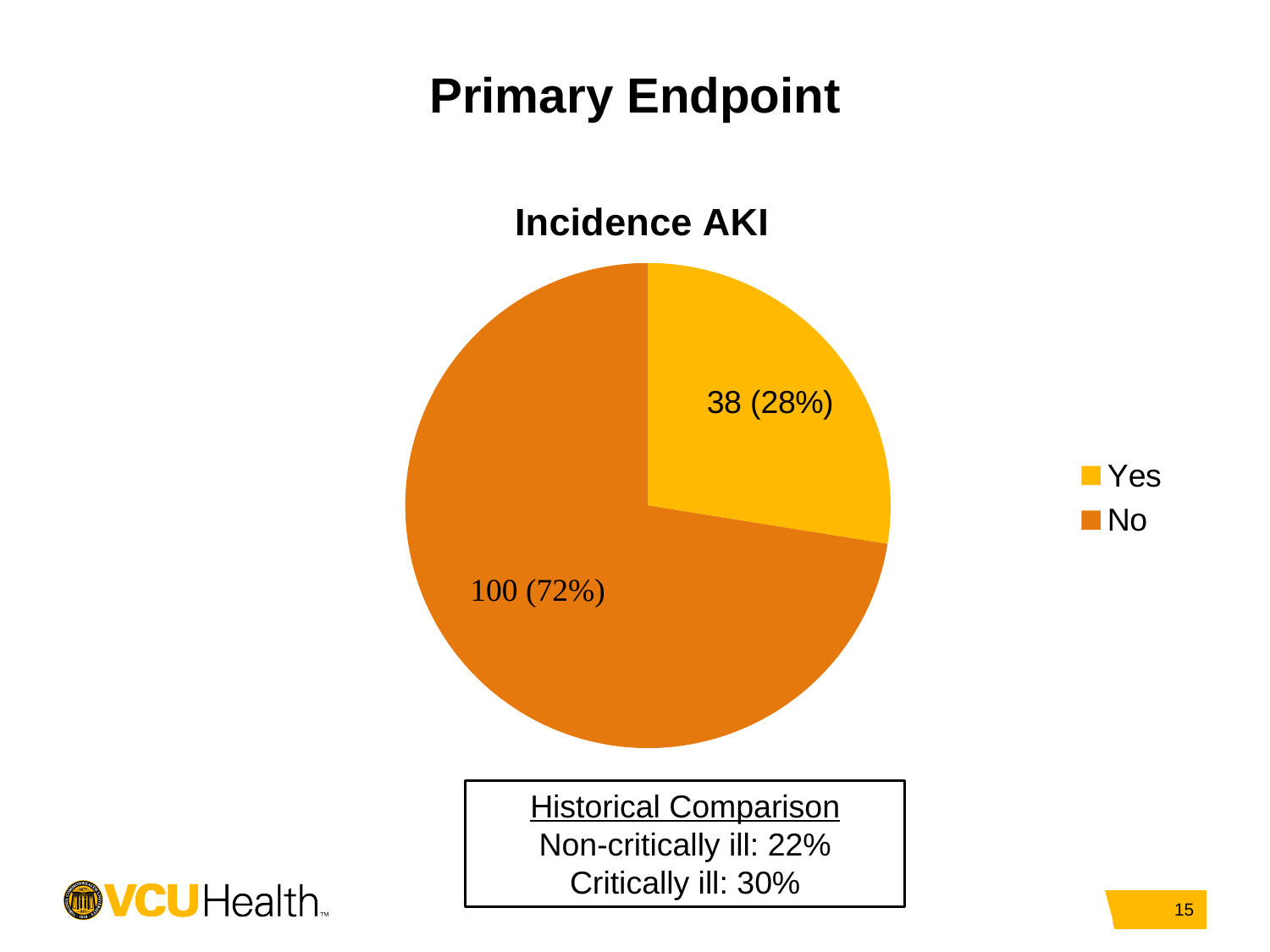
What is the title of the chart? Incidence AKI What type of chart is shown on the slide? pie chart Which slice is the largest? No What is the data label shown on the 'Yes' slice? 38 (28%) What is the data label shown on the 'No' slice? 100 (72%) Which slice is the smallest? Yes What share of the pie does the 'No' slice represent? 72% What share of the pie does the 'Yes' slice represent? 28% How many slices does the pie chart have? 2 How many entries does the legend list? 2 What is the difference in count between the 'No' and 'Yes' slices? 62 What is the total count across both slices of the pie? 138